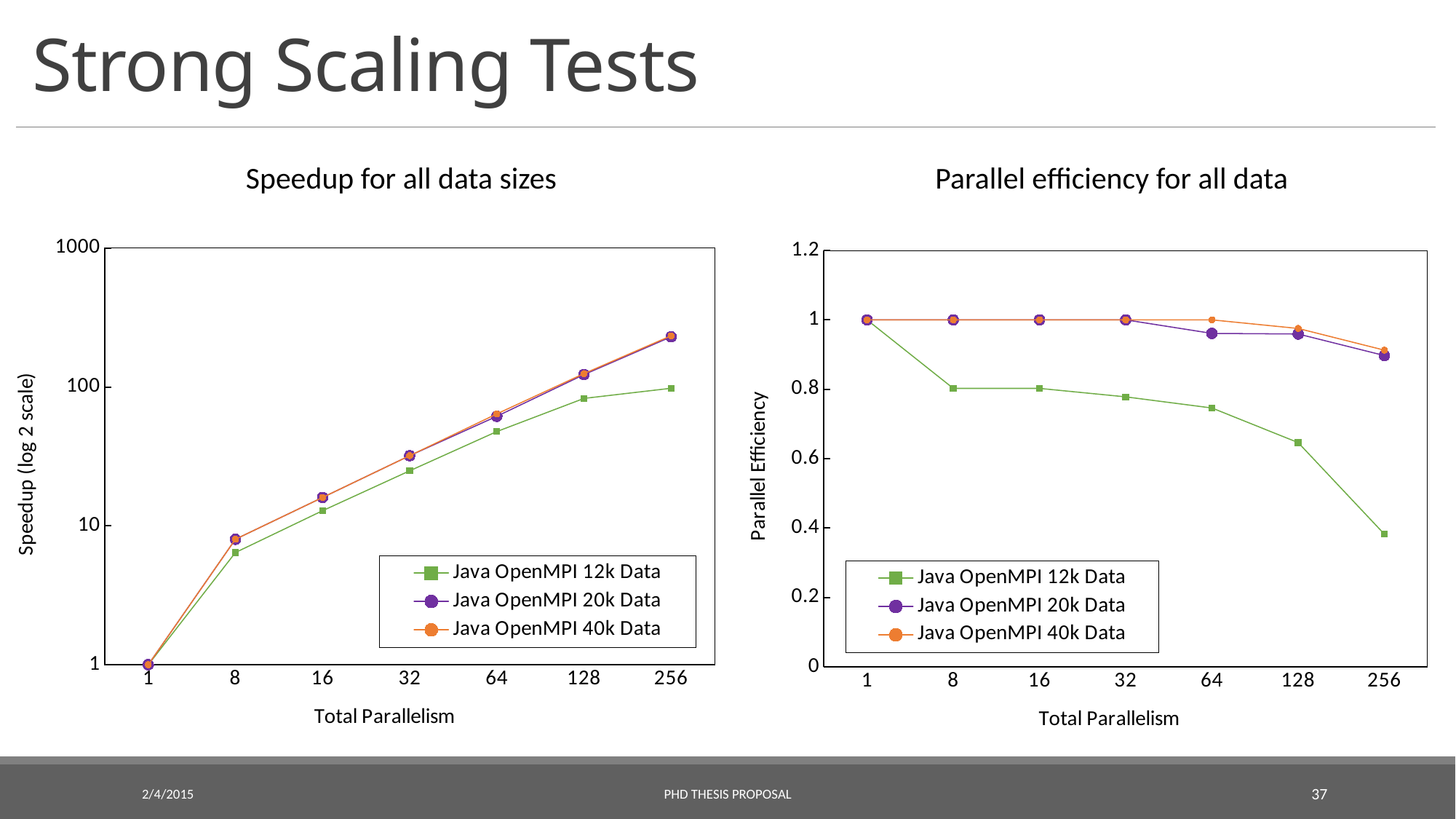
In the "Speedup for all data sizes" chart, is the value for Java OpenMPI 20k Data at Total Parallelism 256 greater or less than 100? greater In the "Parallel efficiency for all data" chart, does the Java OpenMPI 12k Data series rise or fall as Total Parallelism increases? fall In the "Speedup for all data sizes" chart, what is the speedup of Java OpenMPI 40k Data at Total Parallelism 1? 1 In the "Parallel efficiency for all data" chart, at which Total Parallelism value is Java OpenMPI 12k Data lowest? 256 In the "Parallel efficiency for all data" chart, is the value for Java OpenMPI 12k Data at Total Parallelism 128 greater or less than 0.6? greater How many series does the legend of the "Parallel efficiency for all data" chart list? 3 What kind of chart is the "Speedup for all data sizes" chart? line chart In the "Speedup for all data sizes" chart, is the value for Java OpenMPI 12k Data at Total Parallelism 64 greater or less than 100? less In the "Parallel efficiency for all data" chart, which series has the higher value at Total Parallelism 256: Java OpenMPI 12k Data or Java OpenMPI 40k Data? Java OpenMPI 40k Data How many Total Parallelism values are plotted along the x axis of the "Speedup for all data sizes" chart? 7 In the "Parallel efficiency for all data" chart, what is the parallel efficiency of Java OpenMPI 12k Data at Total Parallelism 1? 1